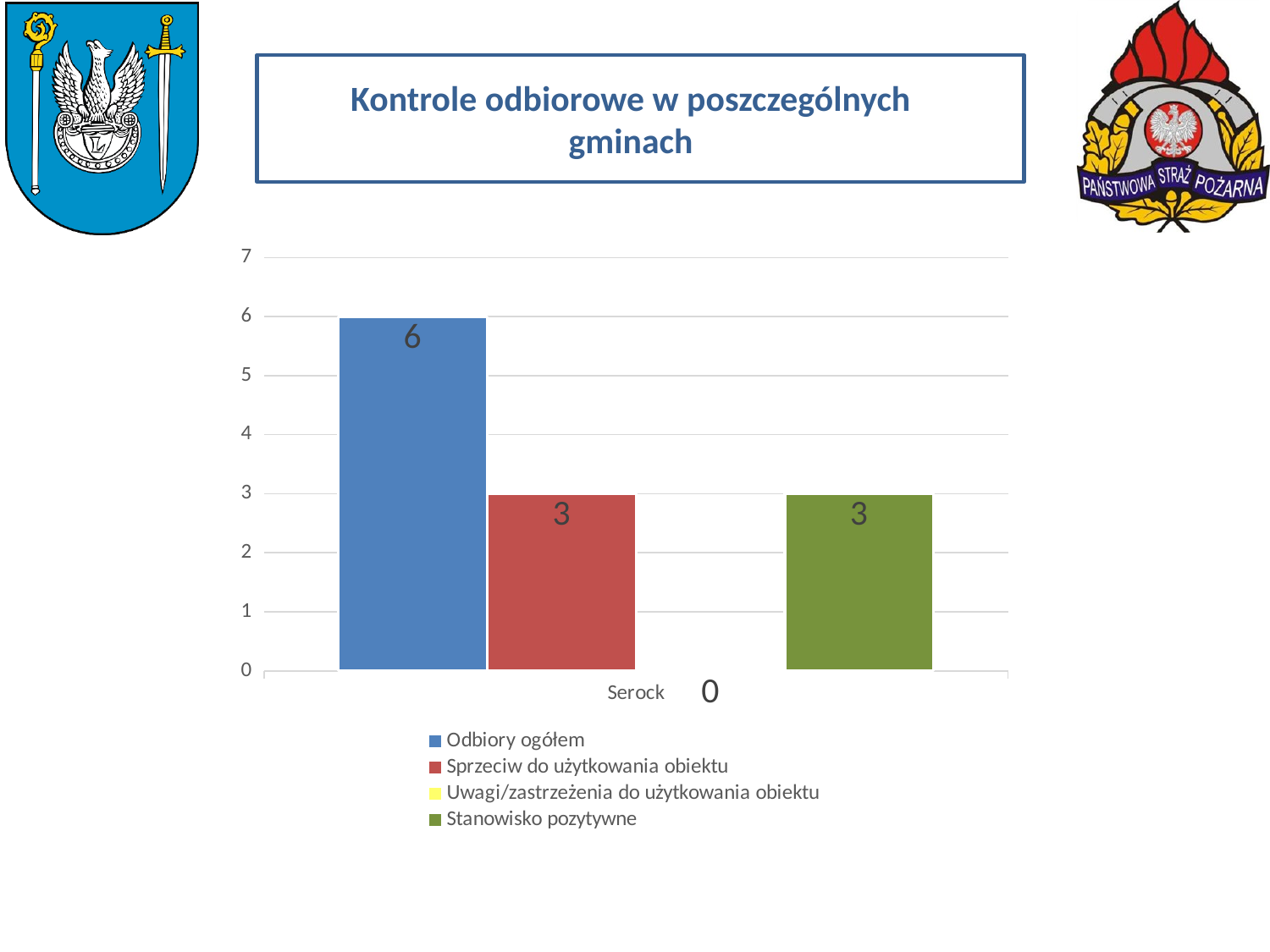
What is the title of the chart? Kontrole odbiorowe w poszczególnych gminach Which is larger for Serock: 'Odbiory ogółem' or 'Stanowisko pozytywne'? Odbiory ogółem What is the value of 'Stanowisko pozytywne' for Serock? 3 What kind of chart is shown on the slide? Bar chart What is the value of 'Odbiory ogółem' for Serock? 6 What is the difference between 'Odbiory ogółem' and 'Sprzeciw do użytkowania obiektu' for Serock? 3 How many categories are shown on the x axis? 1 How many series does the legend list? 4 What is the value of 'Uwagi/zastrzeżenia do użytkowania obiektu' for Serock? 0 What is the value of 'Sprzeciw do użytkowania obiektu' for Serock? 3 Which series has the lowest value for Serock? Uwagi/zastrzeżenia do użytkowania obiektu Which series has the highest value for Serock? Odbiory ogółem